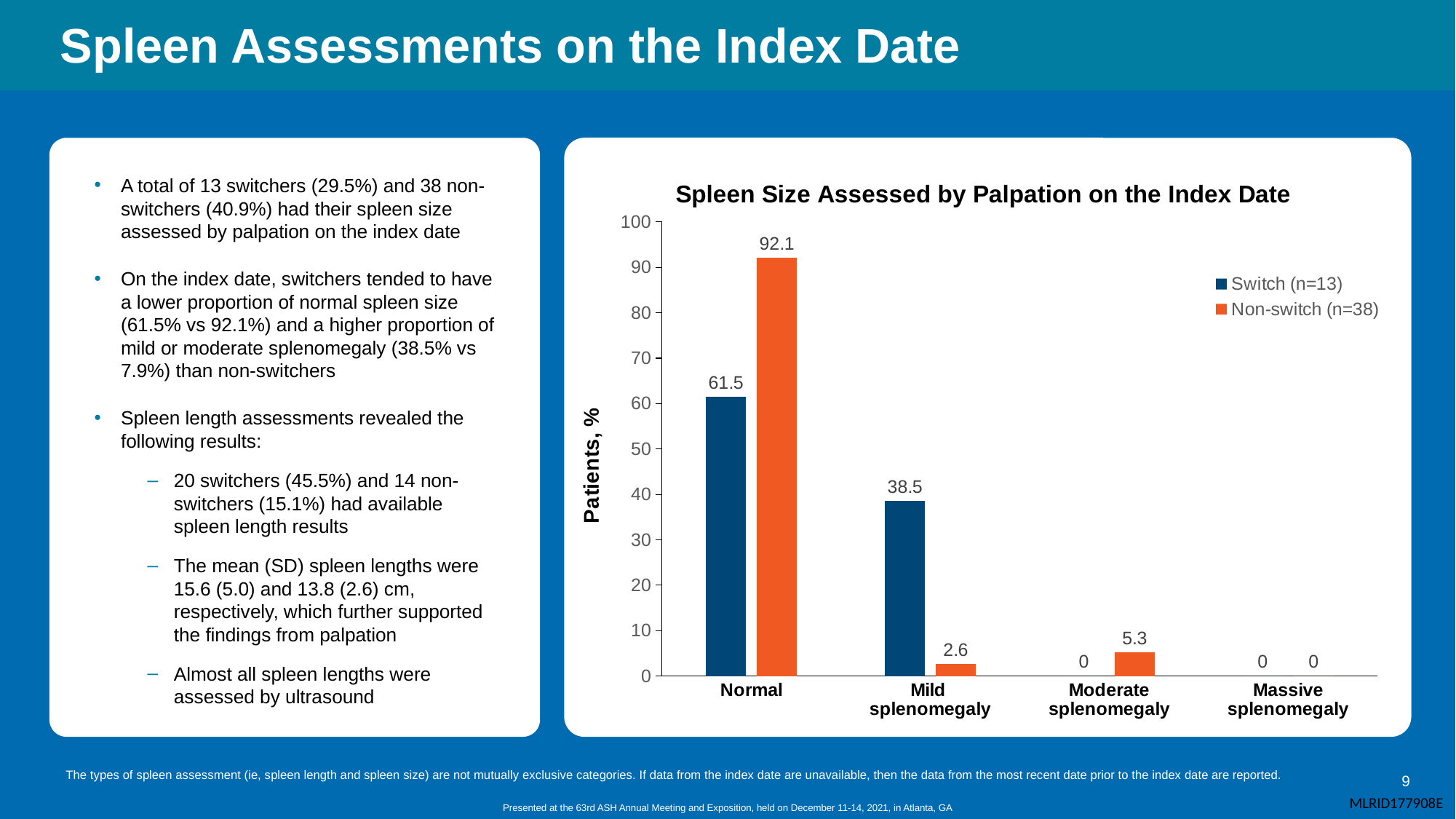
What is the value for Non-switch (n=38) in the Moderate splenomegaly category? 5.3 What is the value for Non-switch (n=38) in the Normal category? 92.1 Which category has the highest value for Non-switch (n=38)? Normal What is the value for Switch (n=13) in the Normal category? 61.5 What is the value for Switch (n=13) in the Mild splenomegaly category? 38.5 In the Mild splenomegaly category, which series has the larger value, Switch (n=13) or Non-switch (n=38)? Switch (n=13) What kind of chart is shown? Bar chart How many categories are shown on the x axis? 4 What is the title of the chart? Spleen Size Assessed by Palpation on the Index Date Which category has the lowest value for Switch (n=13)? Moderate splenomegaly and Massive splenomegaly (both 0) What is the difference between the Non-switch (n=38) and Switch (n=13) values in the Normal category? 30.6 How many series does the legend list? 2